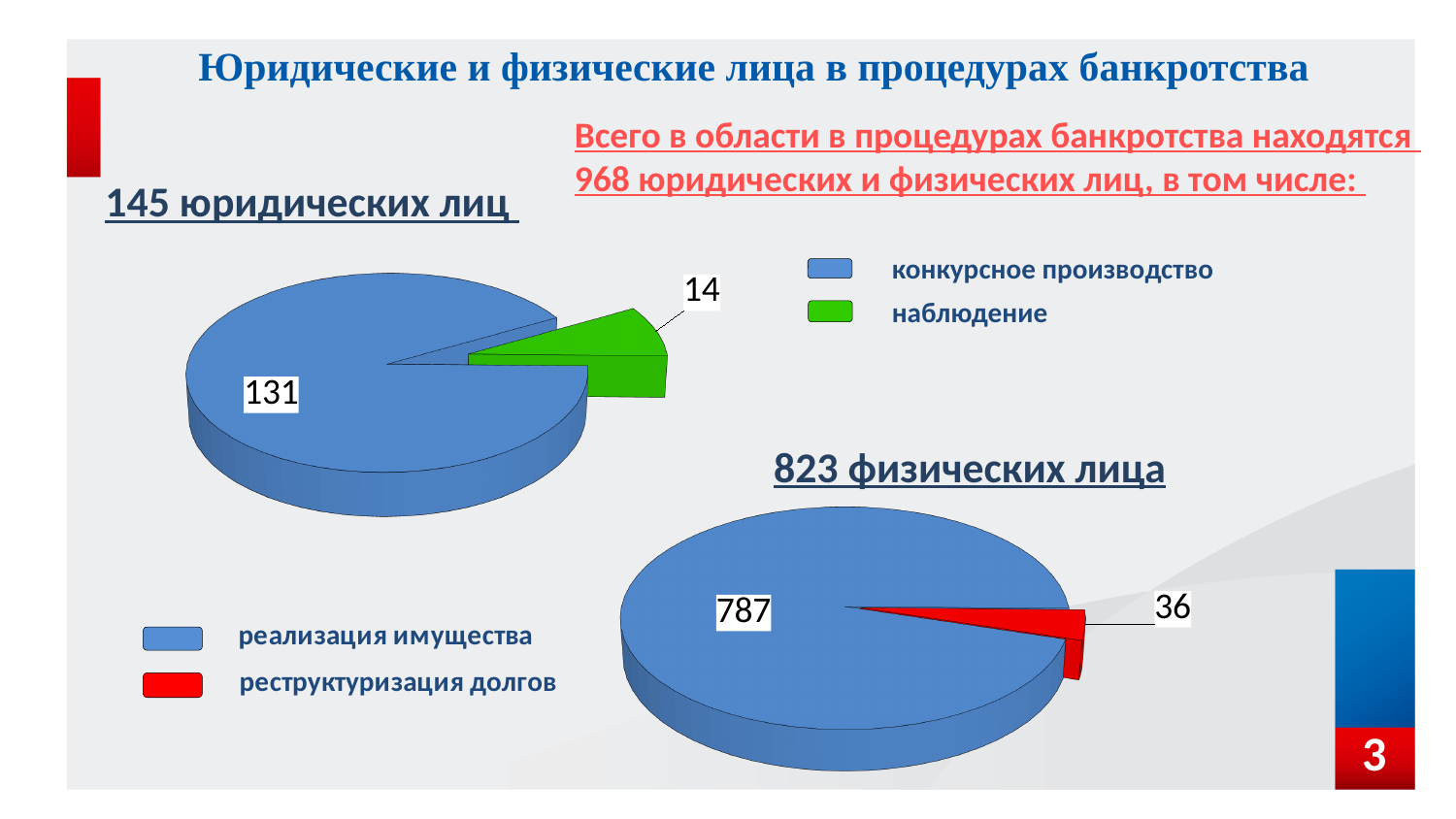
In the pie chart titled "823 физических лица", what is the difference between the values for "реализация имущества" and "реструктуризация долгов"? 751 In the pie chart titled "823 физических лица", which category has the smallest slice? реструктуризация долгов How many slices does the pie chart titled "823 физических лица" have? 2 In the pie chart titled "823 физических лица", what is the value for "реструктуризация долгов"? 36 In the pie chart titled "145 юридических лиц", what is the value for "конкурсное производство"? 131 In the pie chart titled "145 юридических лиц", what is the difference between the values for "конкурсное производство" and "наблюдение"? 117 In the pie chart titled "145 юридических лиц", what is the value for "наблюдение"? 14 What type of chart is used for "145 юридических лиц"? pie chart In the pie chart titled "823 физических лица", what is the value for "реализация имущества"? 787 In the pie chart titled "823 физических лица", what colour is the "реструктуризация долгов" slice? red In the pie chart titled "145 юридических лиц", which category has the largest slice? конкурсное производство